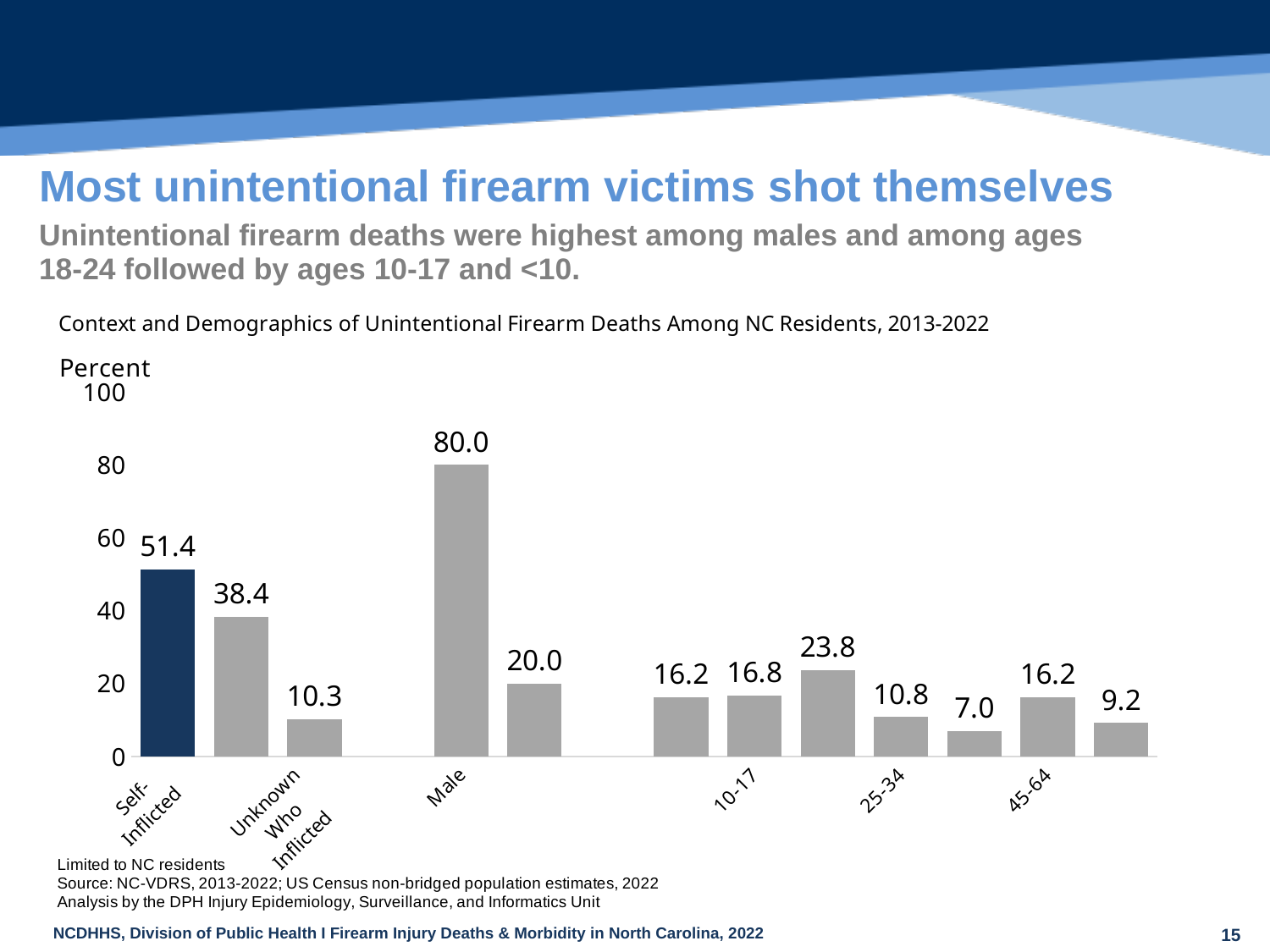
What kind of chart is shown on the slide? bar chart What is the value for Unknown Who Inflicted? 10.3 What is the difference between the values for Male and Self-Inflicted? 28.6 What is the value for Male? 80.0 What is the value for ages 25-34? 10.8 Which category has the highest value in the chart? Male Is the value for Self-Inflicted greater or less than 40? greater What is the value for Self-Inflicted? 51.4 Which is larger, the value for ages 25-34 or the value for ages 45-64? 45-64 What is the value for ages 45-64? 16.2 How many bars are plotted in the chart? 12 What is the difference between the values for Self-Inflicted and Unknown Who Inflicted? 41.1